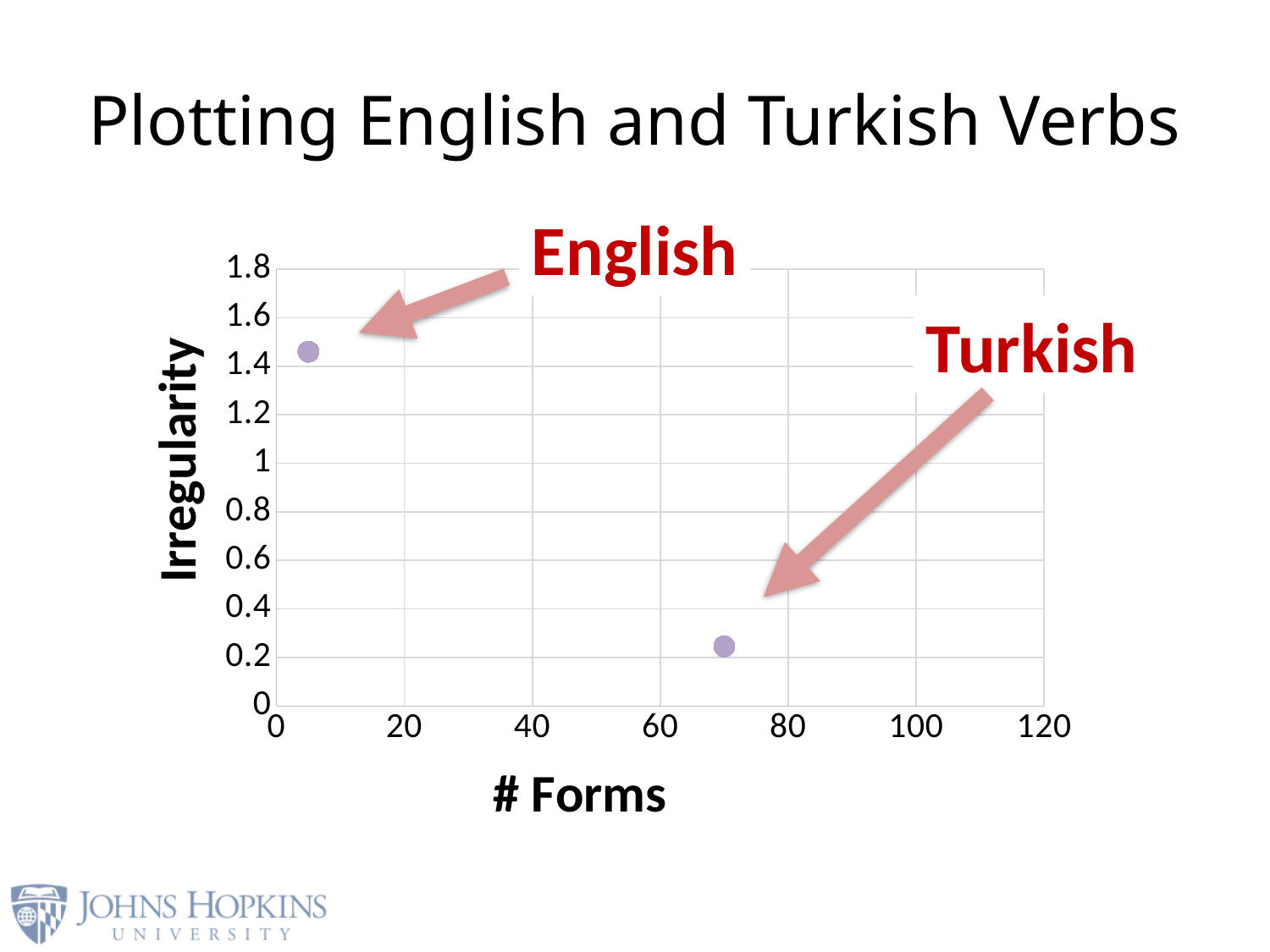
What is the label of the x axis? # Forms Is the number of forms for English greater or less than 20? less How many data points are plotted on the chart? 2 Which language has the larger number of forms, English or Turkish? Turkish Is the number of forms for Turkish greater or less than 60? greater Is the irregularity value for Turkish greater or less than 0.4? less Which point has the highest number of forms? Turkish What kind of chart is shown on the slide? scatter chart Which language has the higher irregularity value, English or Turkish? English Which point has the lowest irregularity? Turkish What is the label of the y axis? Irregularity